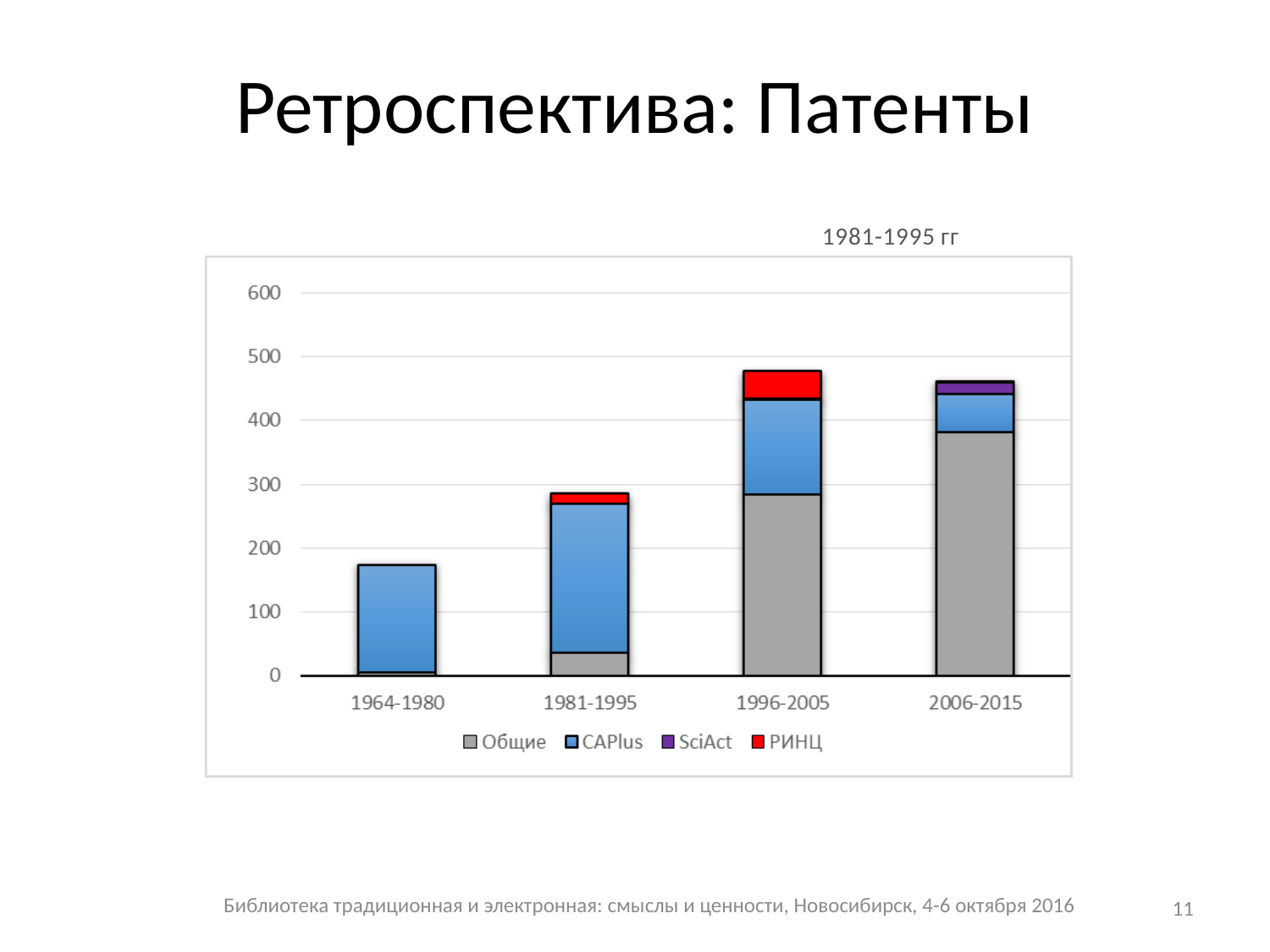
Is the total bar for 1996-2005 greater or less than 400? greater Is the Общие segment for 2006-2015 greater or less than 300? greater How many period categories are shown on the x axis of the chart? 4 Which series appears only in the 2006-2015 bar? SciAct Which series in the legend is shown in red? РИНЦ What kind of chart is shown on the slide? stacked bar chart Is the total bar for 1964-1980 greater or less than 200? less Which total bar is larger, 1964-1980 or 1981-1995? 1981-1995 Which period has the larger Общие segment, 1996-2005 or 2006-2015? 2006-2015 Which period has the lowest total bar in the chart? 1964-1980 How many series does the chart's legend list? 4